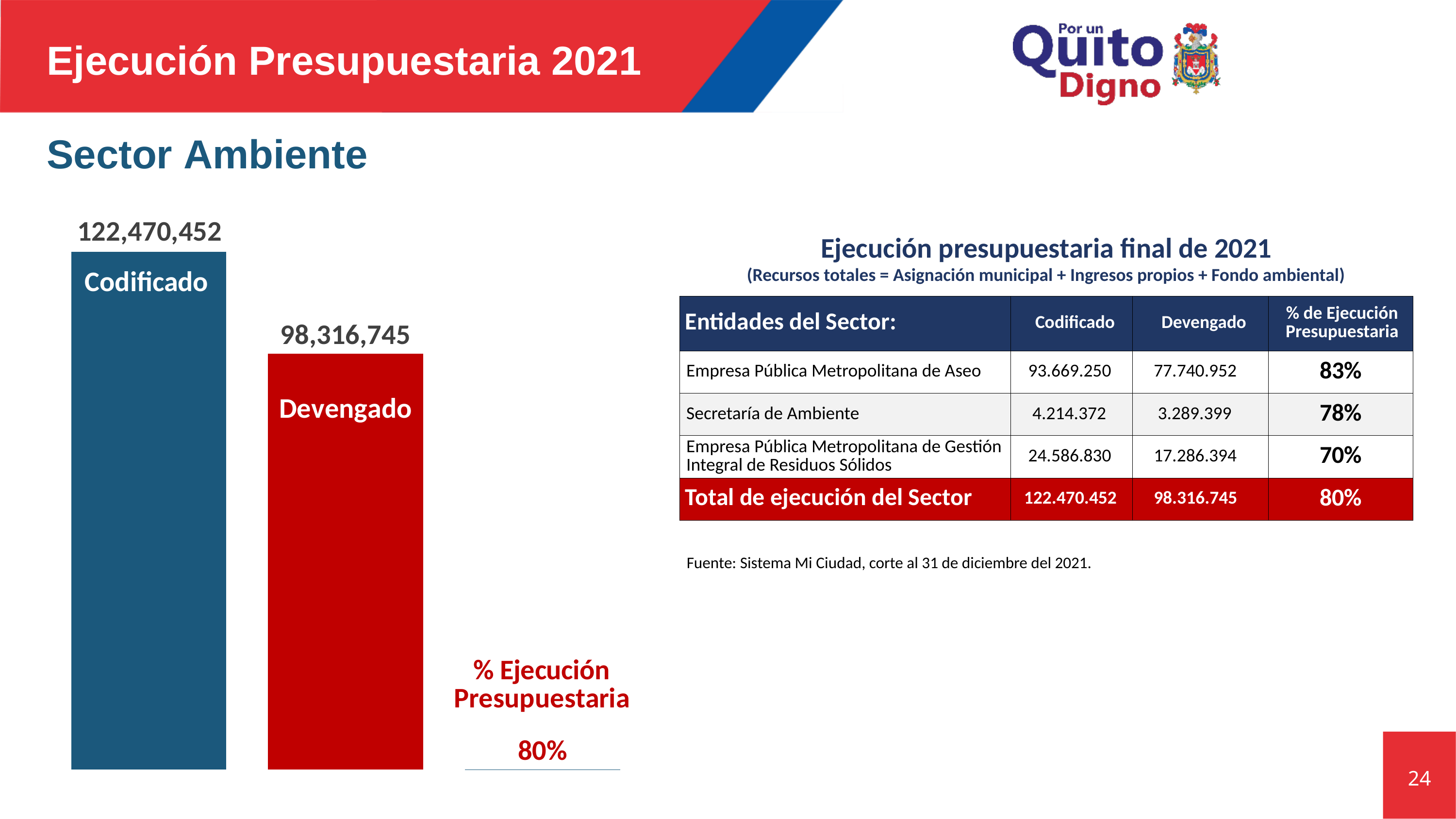
Which bar is the lowest in the chart? Devengado What is the difference between the Codificado and Devengado values? 24,153,707 Which is larger, Codificado or Devengado? Codificado What type of chart is shown on the slide? Bar chart What colour is the Devengado bar? Red How many bars are shown in the chart? 2 Which bar is the highest in the chart? Codificado What percentage is shown next to the bars as the % Ejecución Presupuestaria? 80% What is the value of the Devengado bar? 98,316,745 What is the value of the Codificado bar? 122,470,452